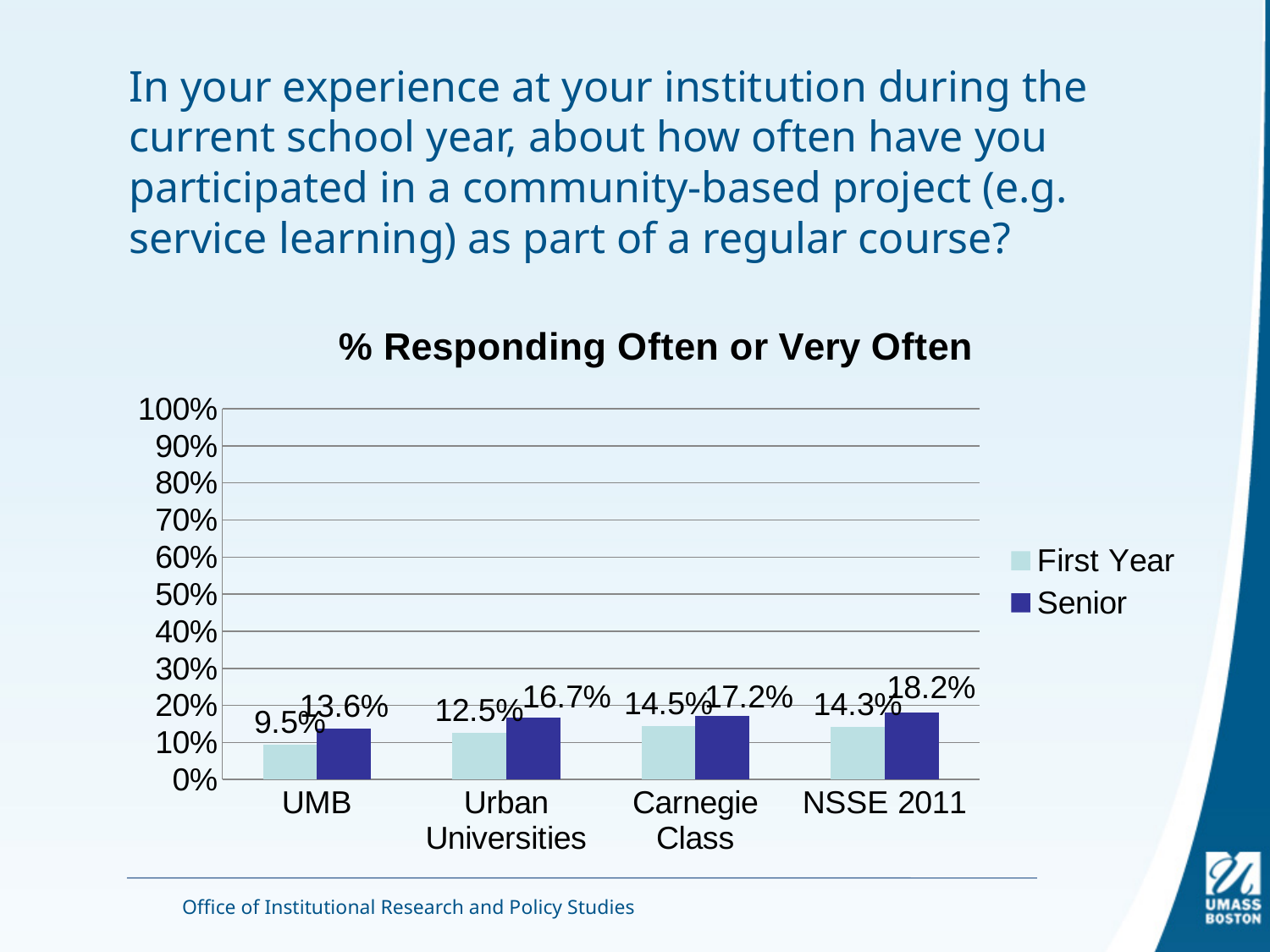
What is the difference between the Senior and First Year values for UMB? 4.1% Which category has the highest Senior value? NSSE 2011 What is the First Year value for UMB? 9.5% What is the Senior value for Urban Universities? 16.7% What kind of chart is shown on the slide? bar chart What is the First Year value for Carnegie Class? 14.5% How many categories are shown on the x axis? 4 How many series does the legend list? 2 Is the Senior value for NSSE 2011 greater or less than 20%? less Which is larger for Carnegie Class, the First Year value or the Senior value? Senior Which category has the lowest First Year value? UMB What is the Senior value for NSSE 2011? 18.2%